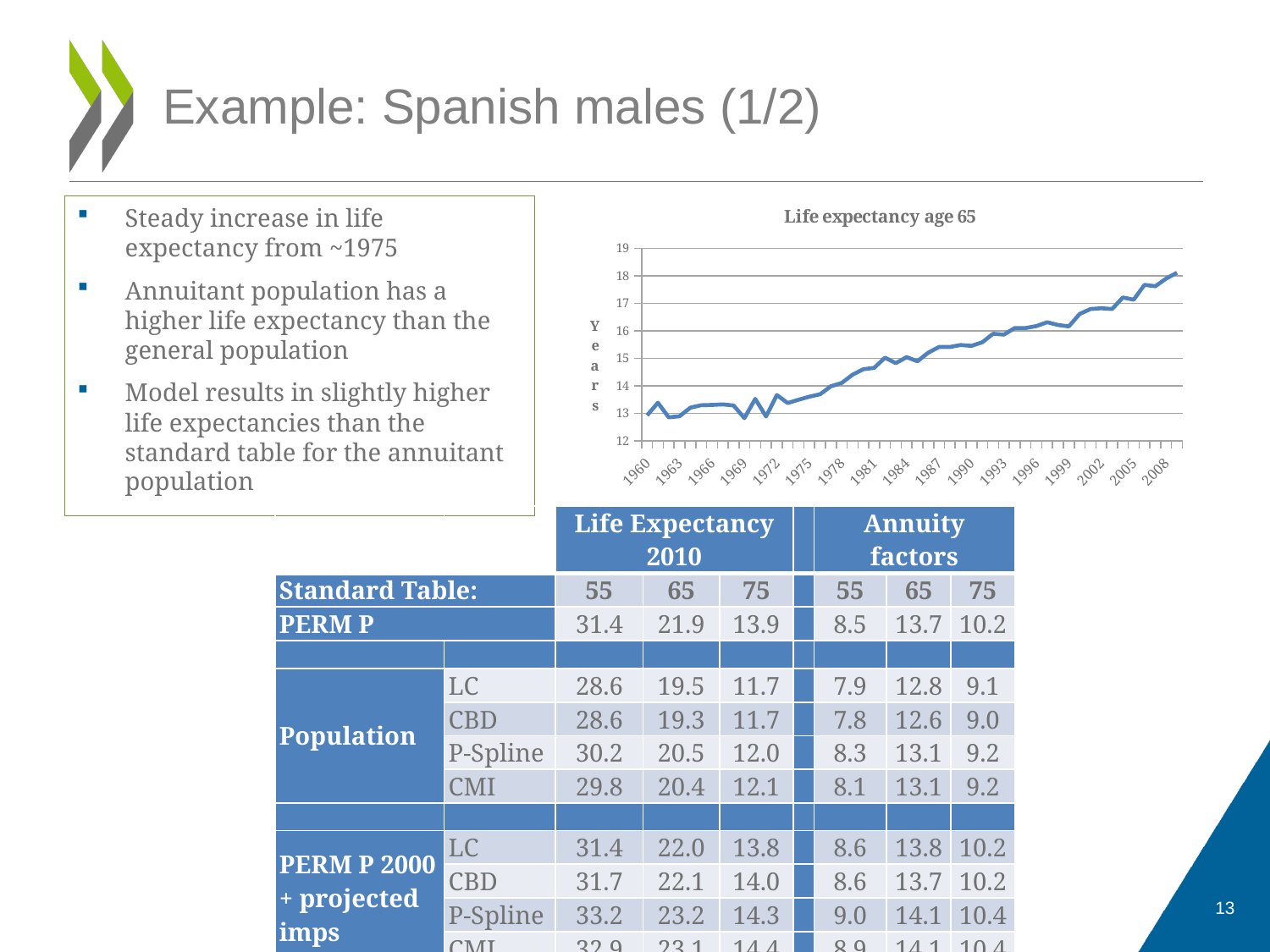
Is the value for 2002 greater or less than 16? greater Is the value for 2008 greater or less than 17? greater Do the values in the chart generally rise or fall from 1960 to 2008? rise What is the title of the chart? Life expectancy age 65 Is the value for 1990 greater or less than 15? greater What is the label on the y axis of the chart? Years Which year has the larger value, 1975 or 1990? 1990 Which year has the larger value, 1960 or 2008? 2008 What kind of chart is shown on the slide? line chart